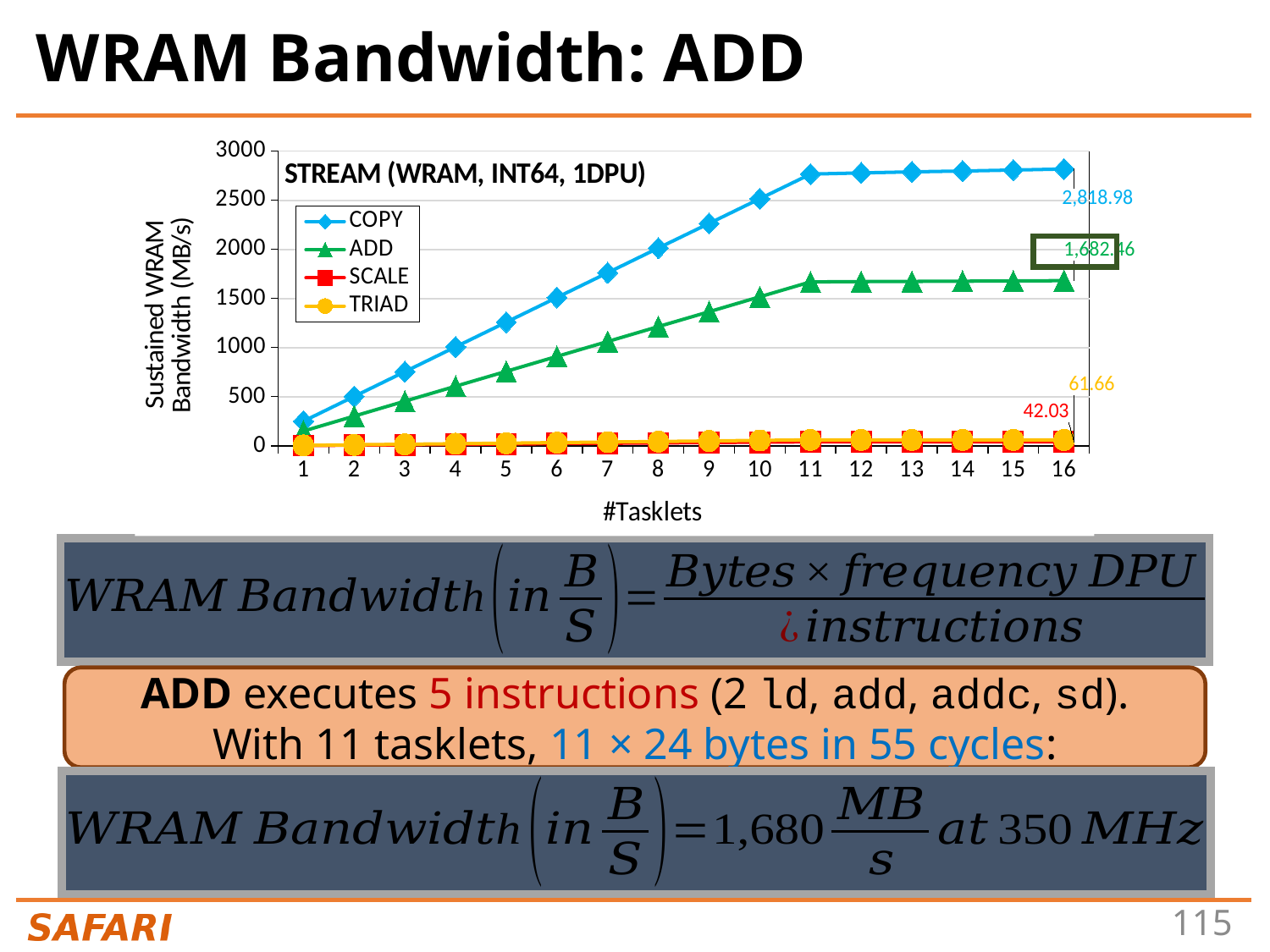
What is the SCALE bandwidth at 16 tasklets? 42.03 What is the title shown inside the chart area? STREAM (WRAM, INT64, 1DPU) Which series has the lowest sustained WRAM bandwidth at 16 tasklets? SCALE What is the COPY bandwidth at 16 tasklets? 2,818.98 How many series does the chart legend list? 4 How many tasklet counts are plotted along the x axis? 16 What is the difference between the TRIAD and SCALE bandwidths at 16 tasklets? 19.63 What is the TRIAD bandwidth at 16 tasklets? 61.66 Which series has the highest sustained WRAM bandwidth at 16 tasklets? COPY At 16 tasklets, which is larger: the TRIAD bandwidth or the SCALE bandwidth? TRIAD Is the ADD bandwidth at 8 tasklets greater or less than 1000? greater What kind of chart is shown on the slide? line chart